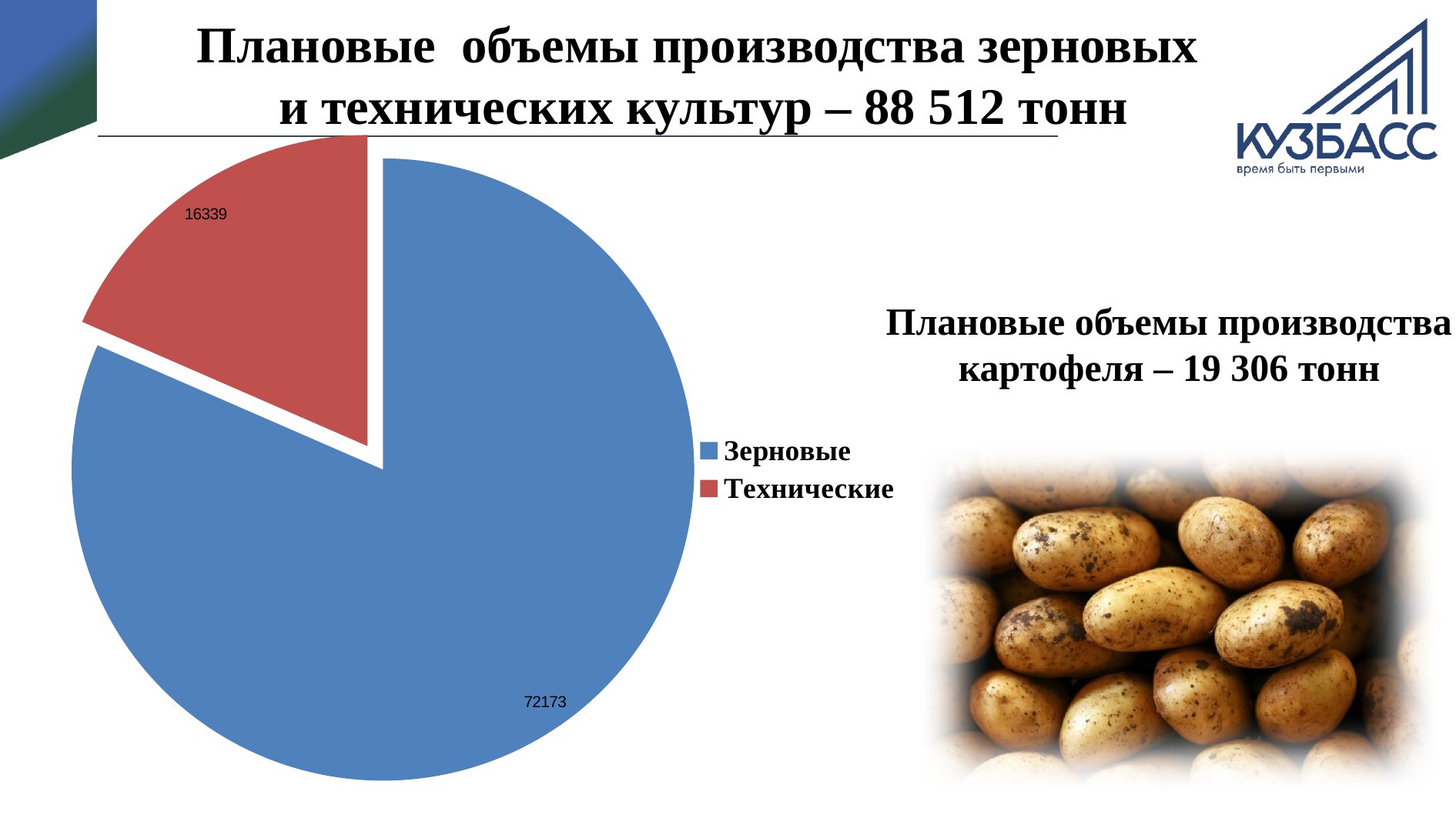
Which category has the smallest slice in the pie chart? Технические What is the value for Зерновые in the pie chart? 72173 How many slices does the pie chart have? 2 Which is larger, the value for Зерновые or the value for Технические? Зерновые What total volume of grain and industrial crops is stated in the slide title? 88 512 тонн What is the difference between the values for Зерновые and Технические? 55834 What type of chart is shown on the slide? pie chart How many entries does the legend list? 2 Which category has the largest slice in the pie chart? Зерновые What colour is the Технические slice in the pie chart? red What is the value for Технические in the pie chart? 16339